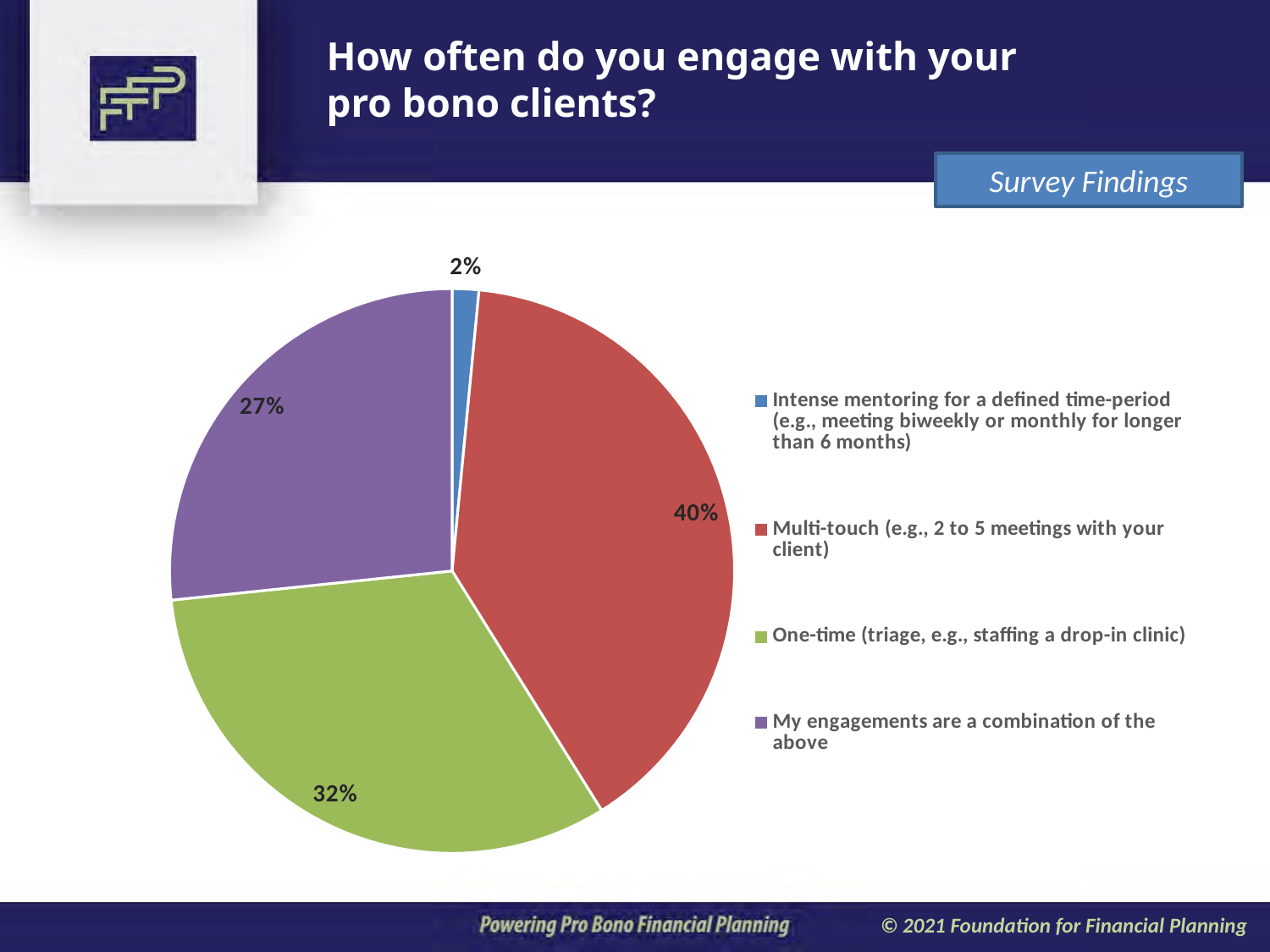
What share of respondents chose "Intense mentoring for a defined time-period"? 2% Which engagement type has the smallest share of the pie? Intense mentoring for a defined time-period Which engagement type has the largest share of the pie? Multi-touch (e.g., 2 to 5 meetings with your client) What share of respondents chose "My engagements are a combination of the above"? 27% What colour is the slice for "One-time (triage, e.g., staffing a drop-in clinic)"? Green What share of respondents chose "Multi-touch (e.g., 2 to 5 meetings with your client)"? 40% Which is larger: the share for One-time or the share for "My engagements are a combination of the above"? One-time What share of respondents chose "One-time (triage, e.g., staffing a drop-in clinic)"? 32% What is the difference in percentage points between the Multi-touch share and the One-time share? 8 How many categories does the pie chart show? 4 What is the title of the slide containing the chart? How often do you engage with your pro bono clients? What kind of chart is shown on the slide? Pie chart